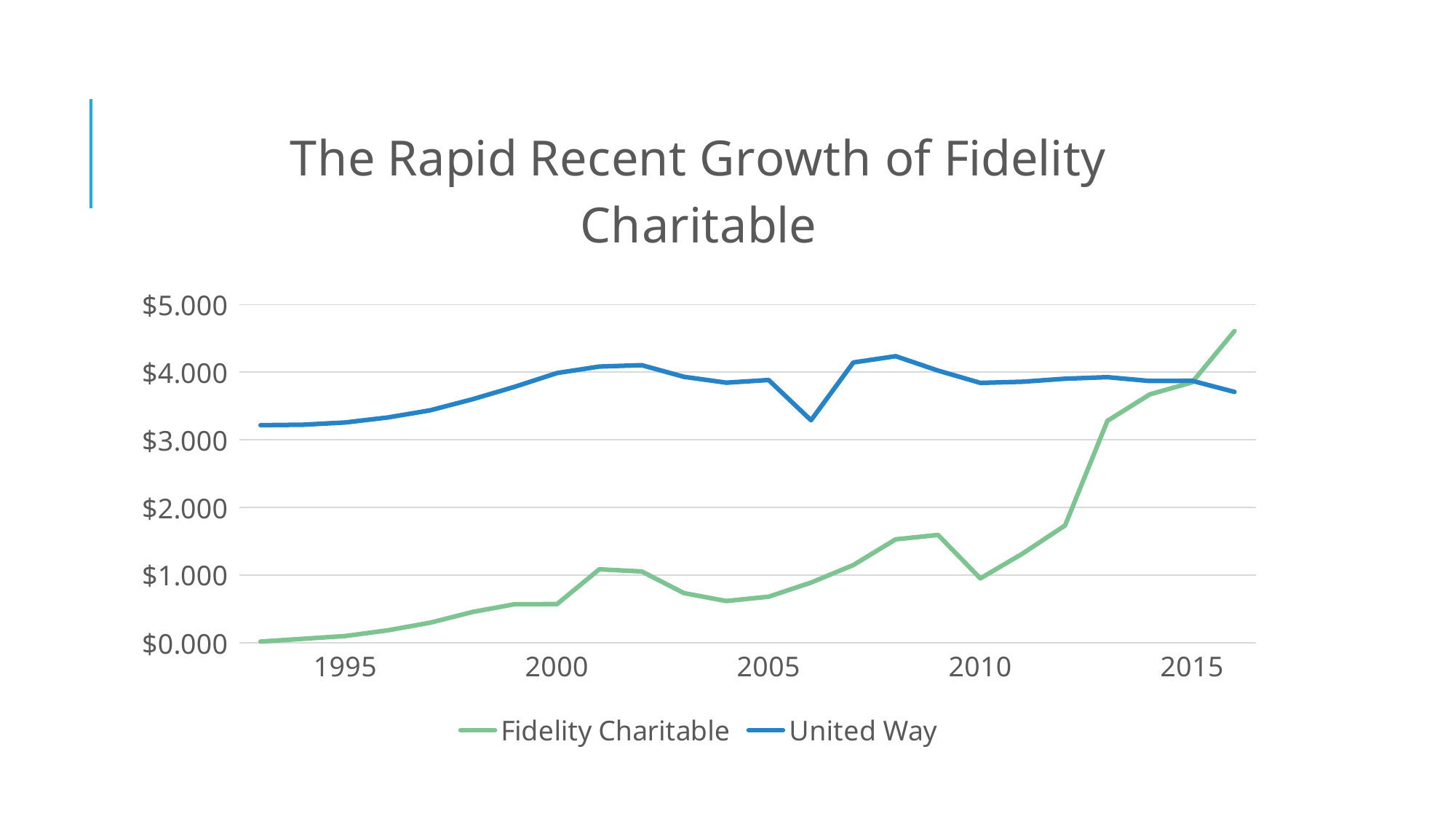
Which colour is used for the United Way line? Blue Is the value for Fidelity Charitable in 2015 greater or less than $3.000? greater What kind of chart is shown on the slide? Line chart How many series does the legend list? 2 Is the value for Fidelity Charitable in 2005 greater or less than $1.000? less Is the value for United Way in 2005 greater or less than $3.000? greater Does the Fidelity Charitable line generally rise or fall from left to right across the chart? Rise What is the title of the chart? The Rapid Recent Growth of Fidelity Charitable At the right end of the chart (after 2015), which series has the higher value, Fidelity Charitable or United Way? Fidelity Charitable In 2005, which series has the higher value, Fidelity Charitable or United Way? United Way